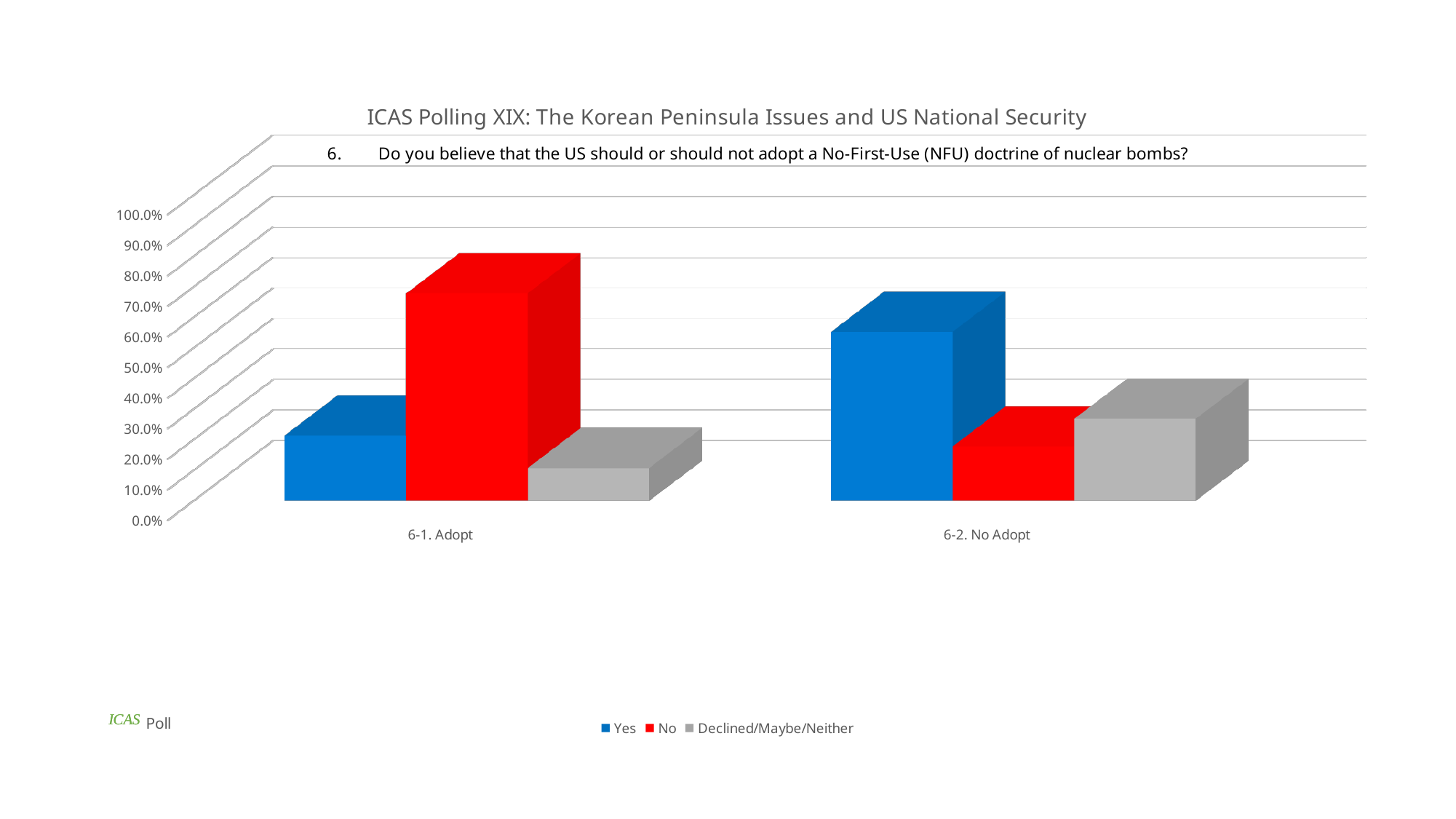
What kind of chart is shown on the slide? bar chart Which colour represents the Declined/Maybe/Neither series in the legend? grey Is the value for Yes in 6-2. No Adopt greater or less than 40.0%? greater Which series has the lowest value for 6-1. Adopt? Declined/Maybe/Neither Is the value for No in 6-2. No Adopt greater or less than 40.0%? less Which series has the highest value for 6-2. No Adopt? Yes For 6-2. No Adopt, which is larger: the Yes value or the No value? Yes Is the value for No in 6-1. Adopt greater or less than 50.0%? greater How many series does the legend list? 3 How many categories are shown on the x axis? 2 Which series has the highest value for 6-1. Adopt? No